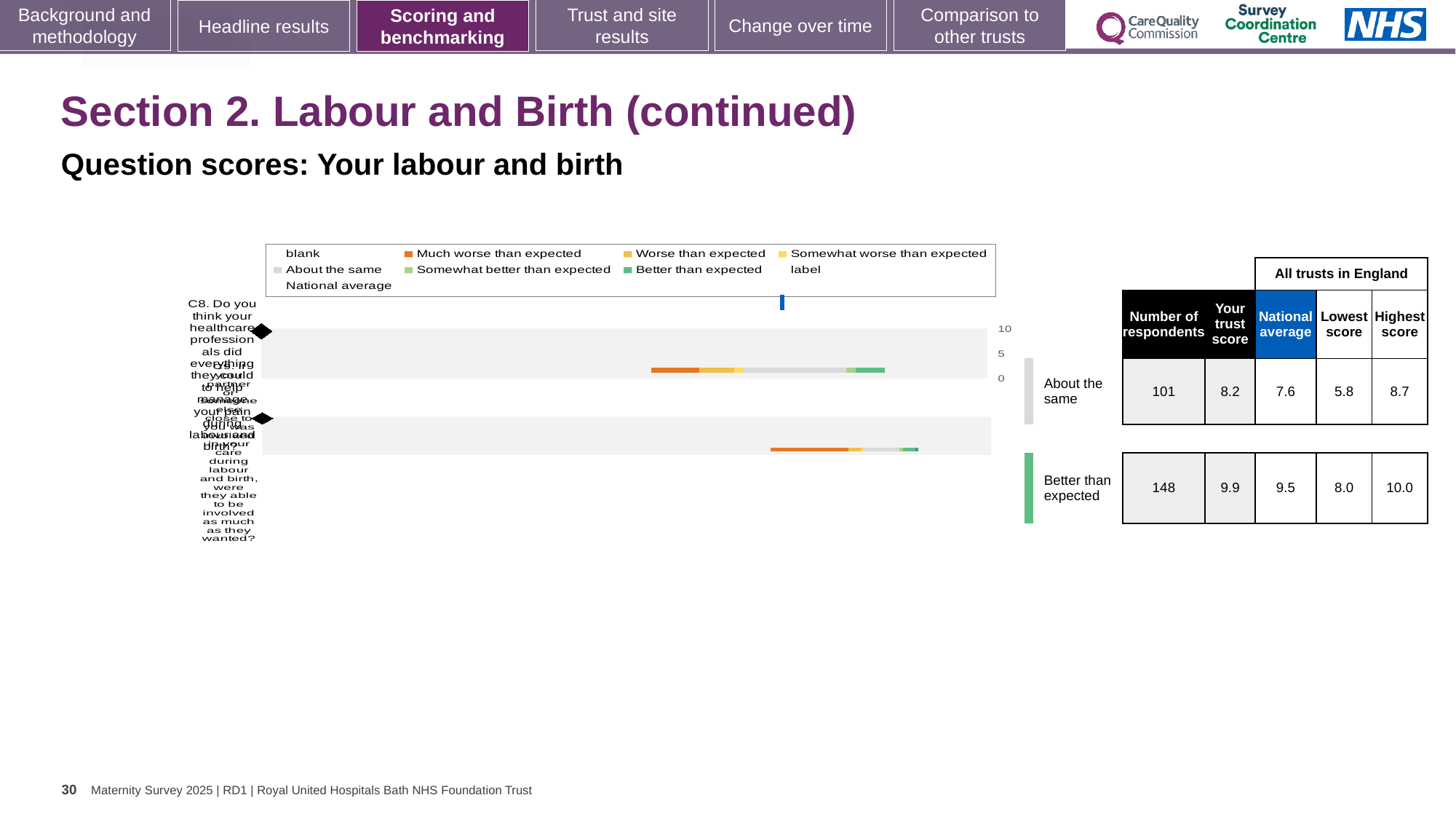
Which colour does the legend use for 'Much worse than expected'? Orange In the table, what is the highest score for the 'Better than expected' row? 10.0 In the table, what is the difference between the trust score and the national average for the 'About the same' row? 0.6 What kind of chart is shown on the slide? Bar chart In the table, what is the lowest score for the 'About the same' row? 5.8 In the table, what is the national average for the 'About the same' row? 7.6 In the table, what is the trust score for the 'Better than expected' row? 9.9 In the table, what is the number of respondents for the 'About the same' row? 101 How many entries does the chart legend list? 9 How many bars are plotted in the chart? 2 What is the highest tick value shown on the chart's axis? 10 In the table, which row has the larger number of respondents, 'About the same' or 'Better than expected'? Better than expected